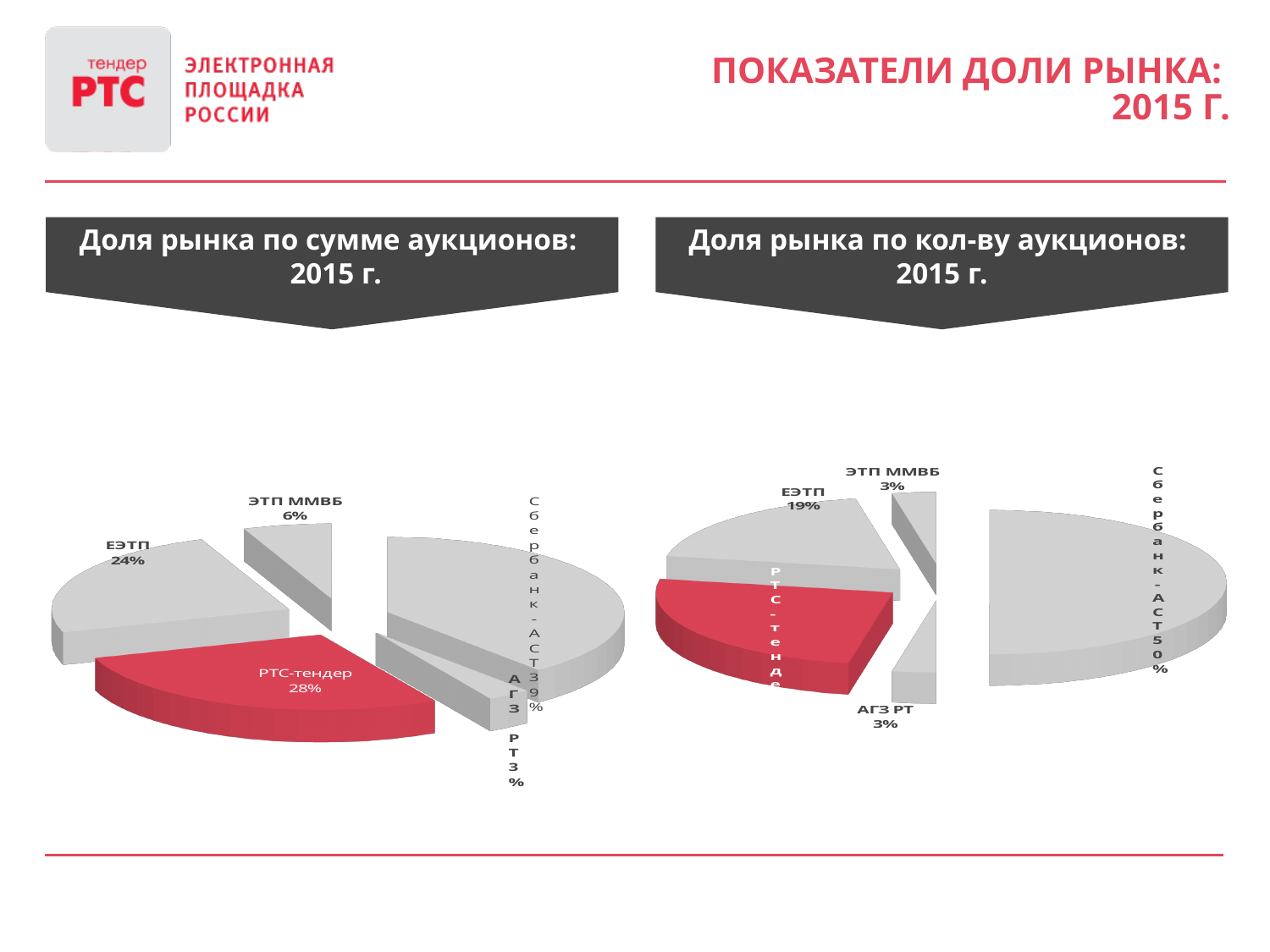
In the left chart (Доля рынка по сумме аукционов: 2015 г.), what is the share for ЕЭТП? 24% In the left chart (Доля рынка по сумме аукционов: 2015 г.), what is the share for РТС-тендер? 28% In the left chart (Доля рынка по сумме аукционов: 2015 г.), what is the share for Сбербанк-АСТ? 39% In the left chart (Доля рынка по сумме аукционов: 2015 г.), which platform has the largest share? Сбербанк-АСТ In the right chart (Доля рынка по кол-ву аукционов: 2015 г.), what is the share for ЭТП ММВБ? 3% In the right chart (Доля рынка по кол-ву аукционов: 2015 г.), which platform has the largest share? Сбербанк-АСТ In the right chart (Доля рынка по кол-ву аукционов: 2015 г.), what is the share for ЕЭТП? 19% In the right chart (Доля рынка по кол-ву аукционов: 2015 г.), what is the share for Сбербанк-АСТ? 50% What type of chart is used on this slide? Pie chart In the left chart (Доля рынка по сумме аукционов: 2015 г.), which platform has the smallest share? АГЗ РТ In the left chart (Доля рынка по сумме аукционов: 2015 г.), which is larger: the share of ЕЭТП or the share of ЭТП ММВБ? ЕЭТП In the left chart (Доля рынка по сумме аукционов: 2015 г.), what is the difference between the shares of Сбербанк-АСТ and РТС-тендер? 11 percentage points